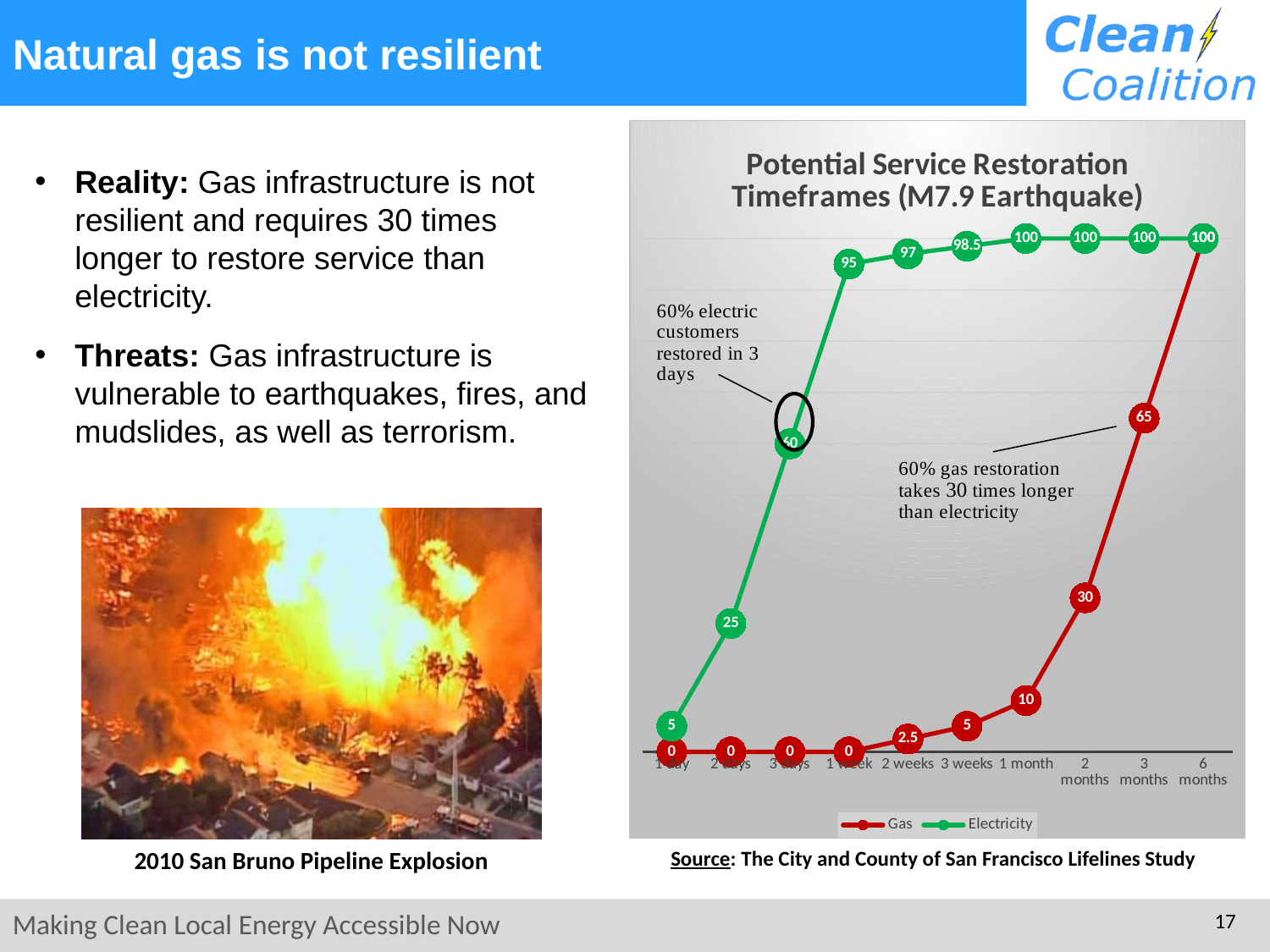
What is the difference between the Electricity and Gas values at 2 months? 70 Which series has the higher value at 1 month, Gas or Electricity? Electricity How many series does the chart legend list? 2 What is the Gas value at 2 weeks? 2.5 Do the Gas values rise or fall along the x axis? Rise How many time points are shown on the x axis of the chart? 10 What is the Electricity value at 3 weeks? 98.5 What is the Electricity value at 1 week? 95 What kind of chart is shown on the slide? Line chart What is the Gas value at 3 months? 65 What is the title of the chart? Potential Service Restoration Timeframes (M7.9 Earthquake) At which time point does the Gas series first reach 100? 6 months